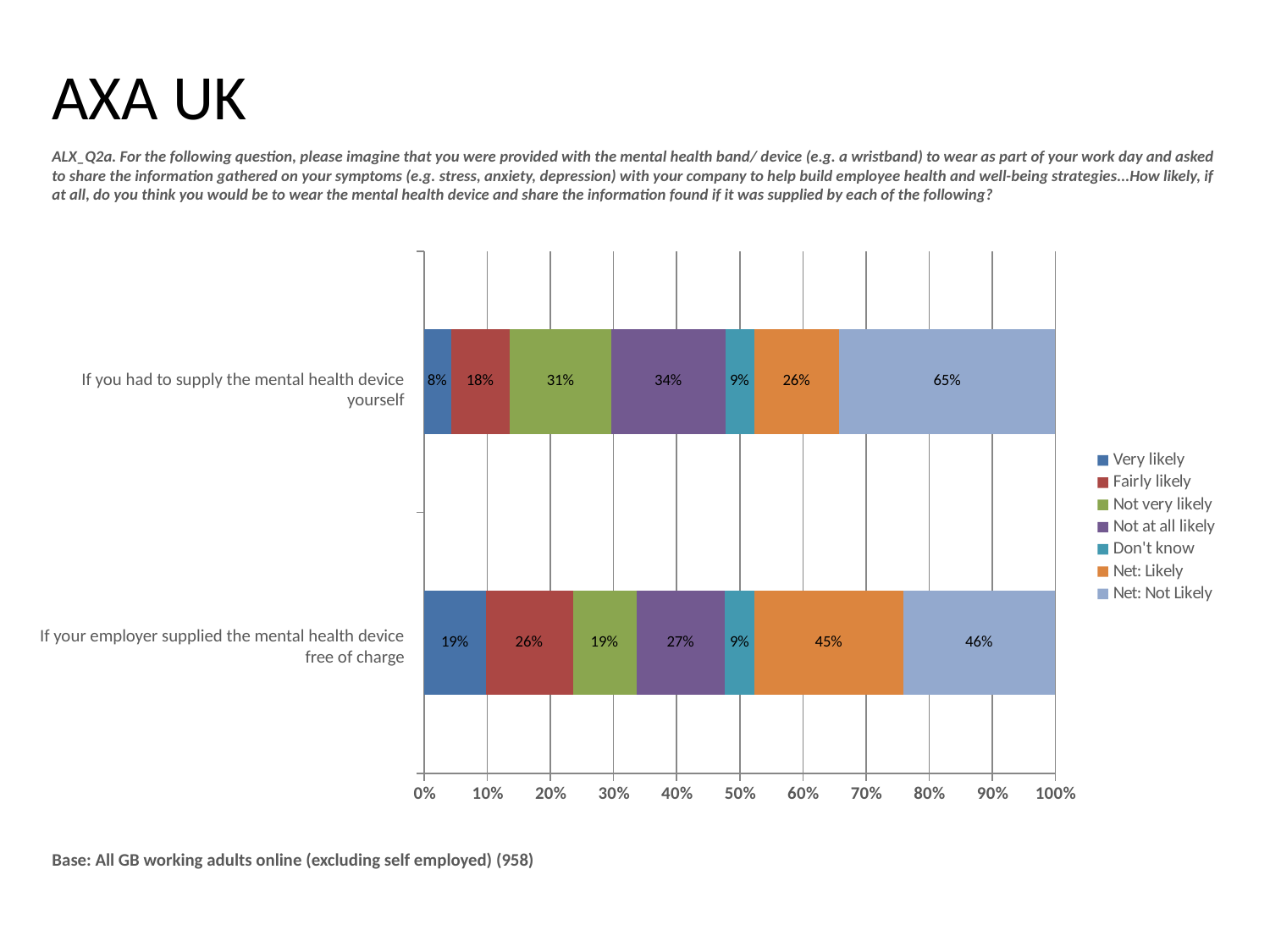
Is the 'Fairly likely' value larger for 'If you had to supply the mental health device yourself' or for 'If your employer supplied the mental health device free of charge'? If your employer supplied the mental health device free of charge What is the 'Don't know' value for 'If your employer supplied the mental health device free of charge'? 9% What is the 'Not at all likely' value for 'If you had to supply the mental health device yourself'? 34% What kind of chart is shown on the slide? Stacked bar chart What is the 'Net: Likely' value for 'If your employer supplied the mental health device free of charge'? 45% How many categories (bars) are plotted on the chart? 2 What is the 'Very likely' value for 'If your employer supplied the mental health device free of charge'? 19% Which legend entry is shown in orange? Net: Likely What is the difference in 'Net: Not Likely' between 'If you had to supply the mental health device yourself' and 'If your employer supplied the mental health device free of charge'? 19% What is the 'Net: Not Likely' value for 'If you had to supply the mental health device yourself'? 65% How many series does the legend list? 7 Which category has the higher 'Net: Likely' value? If your employer supplied the mental health device free of charge